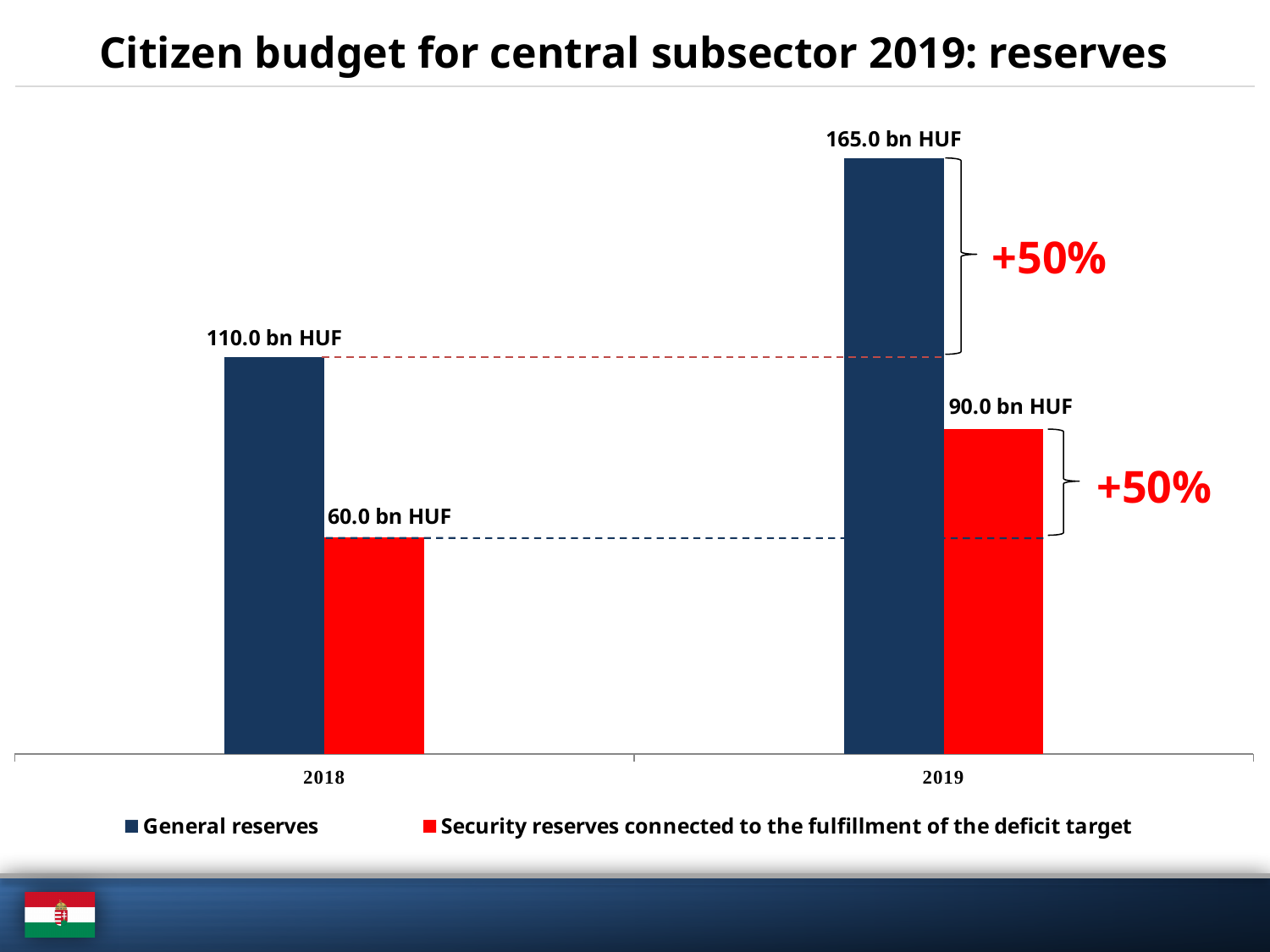
What is the value of General reserves in 2019? 165.0 bn HUF What kind of chart is shown on the slide? Bar chart Which year has the higher value for General reserves? 2019 What is the value of Security reserves connected to the fulfillment of the deficit target in 2019? 90.0 bn HUF By what percentage did General reserves increase from 2018 to 2019, according to the annotation on the chart? +50% What is the difference between Security reserves in 2019 and Security reserves in 2018? 30.0 bn HUF What is the value of General reserves in 2018? 110.0 bn HUF Which bar shows the lowest value on the chart? Security reserves connected to the fulfillment of the deficit target in 2018 What is the difference between General reserves in 2019 and General reserves in 2018? 55.0 bn HUF What is the value of Security reserves connected to the fulfillment of the deficit target in 2018? 60.0 bn HUF Which is larger in 2019: General reserves or Security reserves connected to the fulfillment of the deficit target? General reserves How many series does the legend list? 2